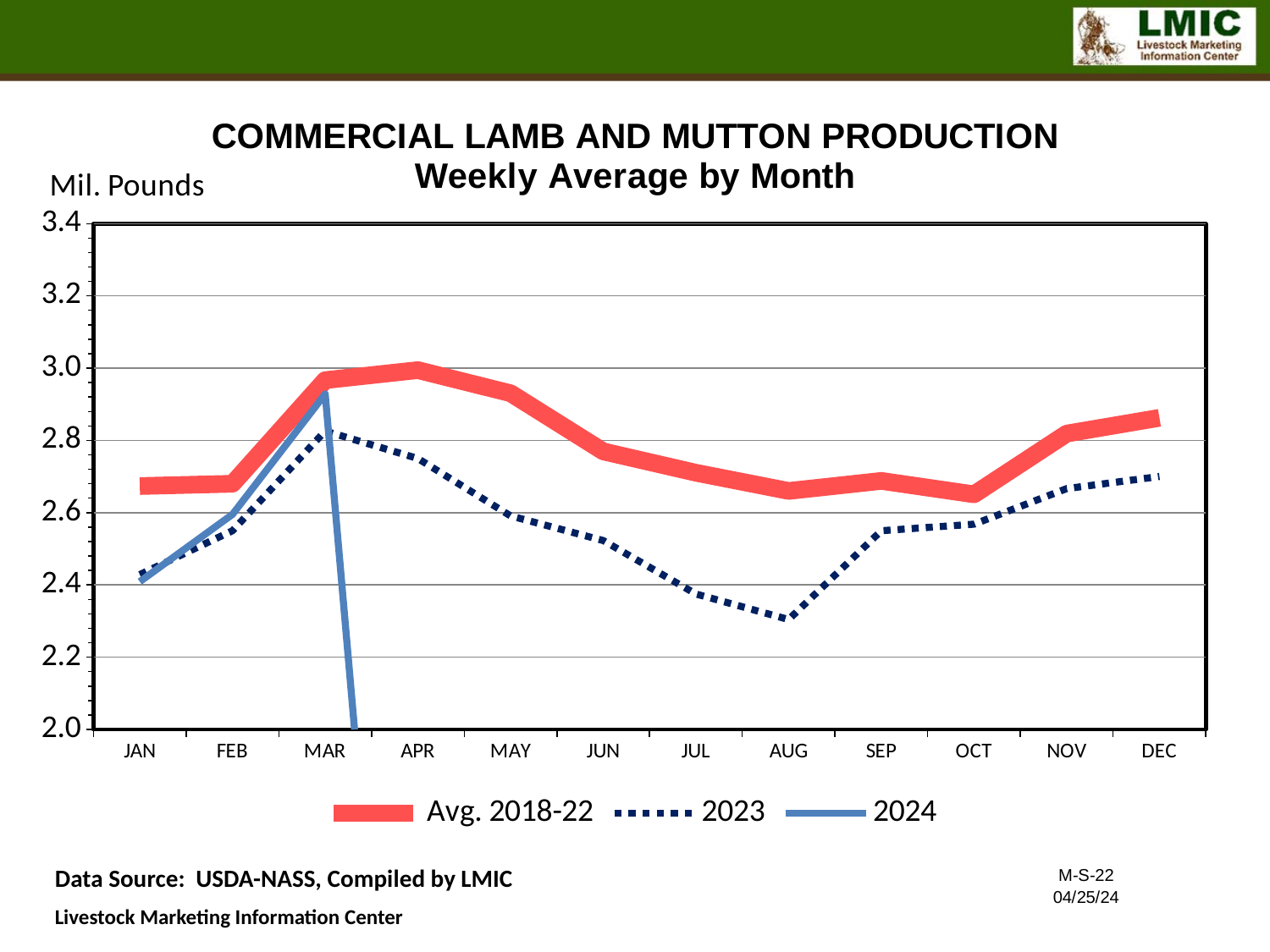
Is the value for 2023 in AUG greater or less than 2.4? less In which month does the 2023 series reach its lowest value? AUG Is the value for 2024 in MAR greater or less than 2.8? greater What unit is shown on the y axis of the chart? Mil. Pounds In which month does the Avg. 2018-22 series reach its highest value? APR How many series does the legend list? 3 Does the 2023 series rise or fall from MAR to AUG? fall Is the value for Avg. 2018-22 in APR greater or less than 2.8? greater Which is larger in JUL, the Avg. 2018-22 value or the 2023 value? Avg. 2018-22 In which month does the 2023 series reach its highest value? MAR What kind of chart is shown on the slide? line chart How many months are shown along the x axis? 12